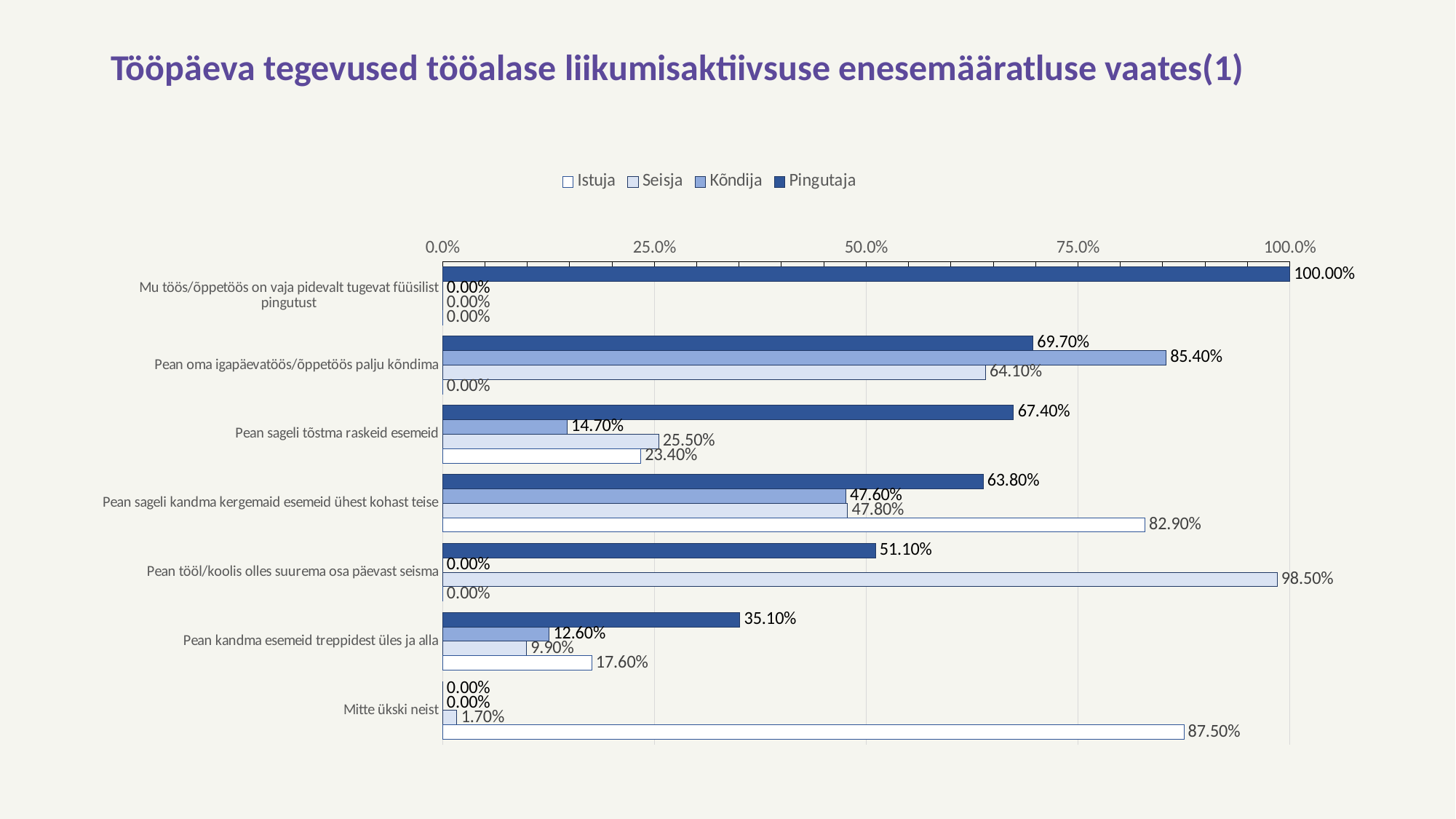
How many categories are shown on the y axis? 7 Which category has the highest Pingutaja value? Mu töös/õppetöös on vaja pidevalt tugevat füüsilist pingutust What is the Pingutaja value for "Mu töös/õppetöös on vaja pidevalt tugevat füüsilist pingutust"? 100.00% For "Pean sageli kandma kergemaid esemeid ühest kohast teise", which is larger: the Istuja value or the Pingutaja value? Istuja What is the Istuja value for "Mitte ükski neist"? 87.50% How many series does the legend list? 4 What is the difference between the Pingutaja and Kõndija values for "Pean sageli tõstma raskeid esemeid"? 52.70% What is the Seisja value for "Pean tööl/koolis olles suurema osa päevast seisma"? 98.50% What kind of chart is shown on the slide? Bar chart Which series is shown with the darkest blue bars? Pingutaja What is the Kõndija value for "Pean oma igapäevatöös/õppetöös palju kõndima"? 85.40% Which category has the lowest Istuja value that is not 0.00%? Pean kandma esemeid treppidest üles ja alla